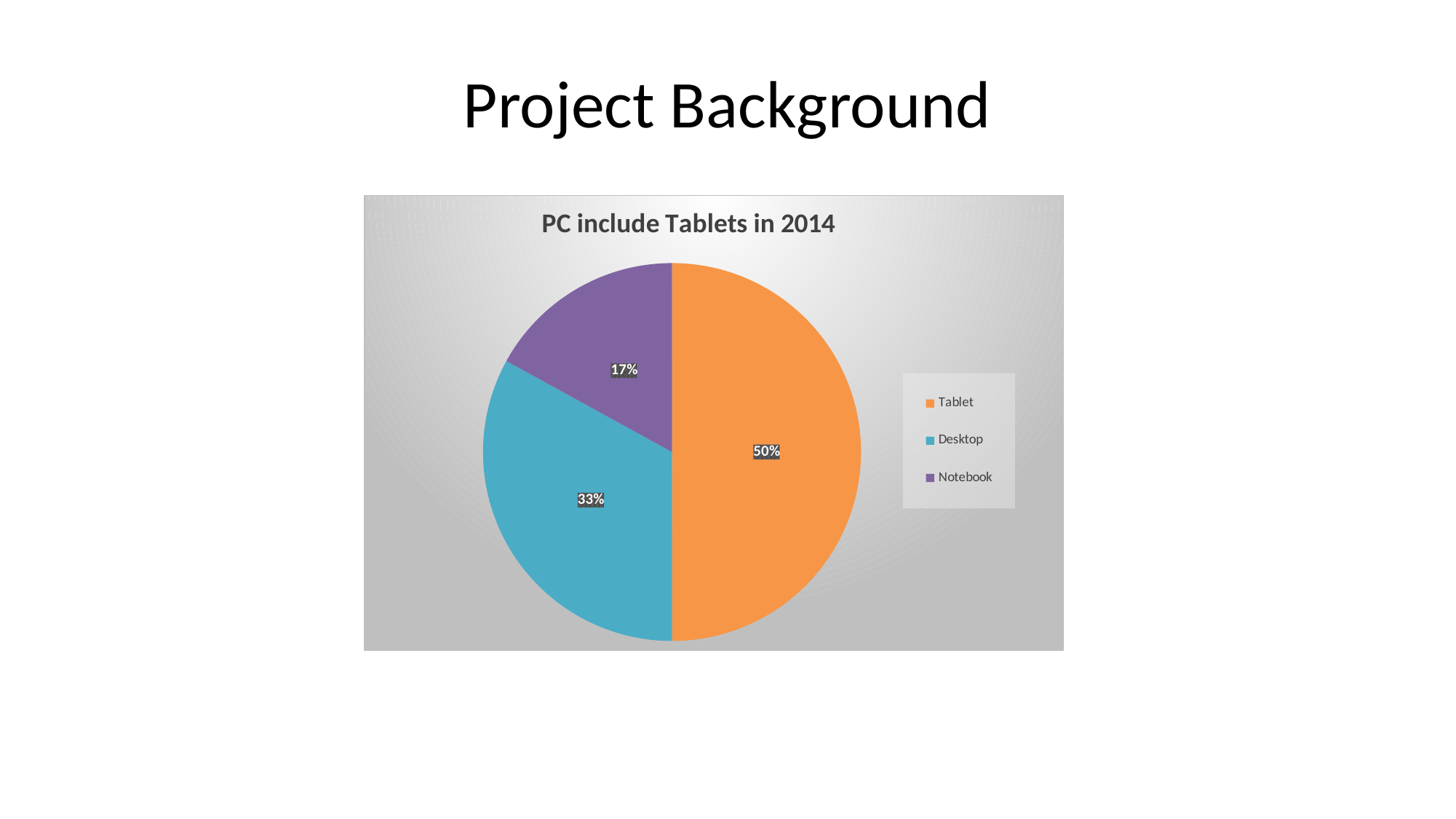
What share of the pie does Desktop have? 33% Which category has the largest slice of the pie? Tablet What kind of chart is shown on the slide? Pie chart What is the difference in percentage points between the Desktop and Notebook slices? 16 What is the title of the chart? PC include Tablets in 2014 How many categories are shown in the pie chart? 3 Which is larger, the Desktop slice or the Notebook slice? Desktop What colour is the Desktop slice in the pie chart? Blue What share of the pie does Notebook have? 17% What is the difference in percentage points between the Tablet and Desktop slices? 17 What share of the pie does Tablet have? 50% Which category has the smallest slice of the pie? Notebook